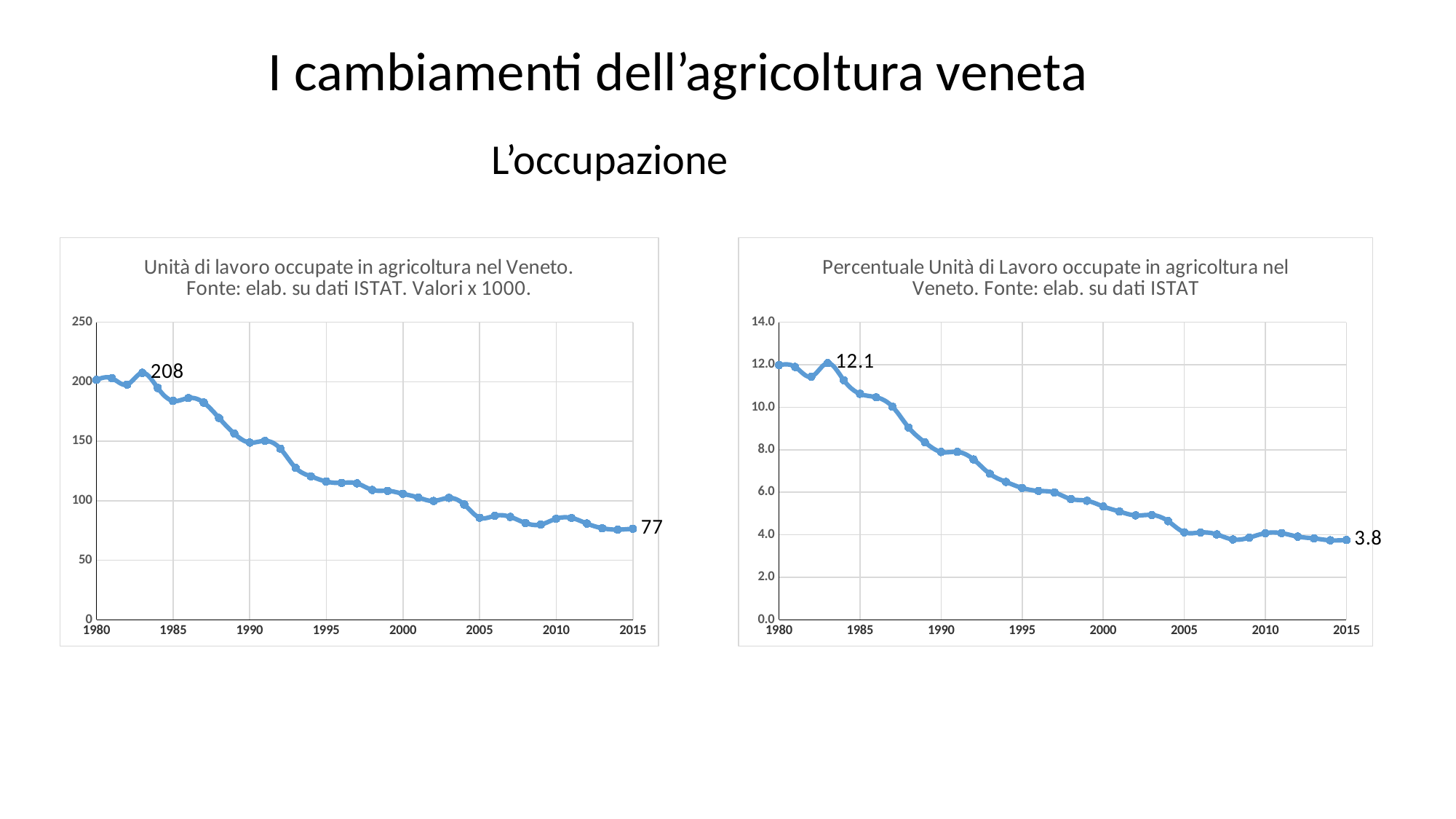
In the right chart (Percentuale Unità di Lavoro occupate in agricoltura nel Veneto), do the values generally rise or fall from 1980 to 2015? fall In the left chart (Unità di lavoro occupate in agricoltura nel Veneto), what is the labelled value for 2015? 77 In the left chart, is the value for 1995 greater or less than 150? less In the right chart, is the value for 2000 greater or less than 6.0? less In the right chart, is the value for 1985 greater or less than 10.0? greater In the right chart (Percentuale Unità di Lavoro occupate in agricoltura nel Veneto), what is the labelled value for 2015? 3.8 What kind of chart is the left chart (Unità di lavoro occupate in agricoltura nel Veneto)? line chart In the right chart (Percentuale Unità di Lavoro occupate in agricoltura nel Veneto), what is the labelled peak value? 12.1 In the left chart, what is the difference between the labelled peak value 208 and the 2015 value 77? 131 In the right chart, what is the difference between the labelled peak value 12.1 and the 2015 value 3.8? 8.3 In the left chart (Unità di lavoro occupate in agricoltura nel Veneto), what is the labelled peak value? 208